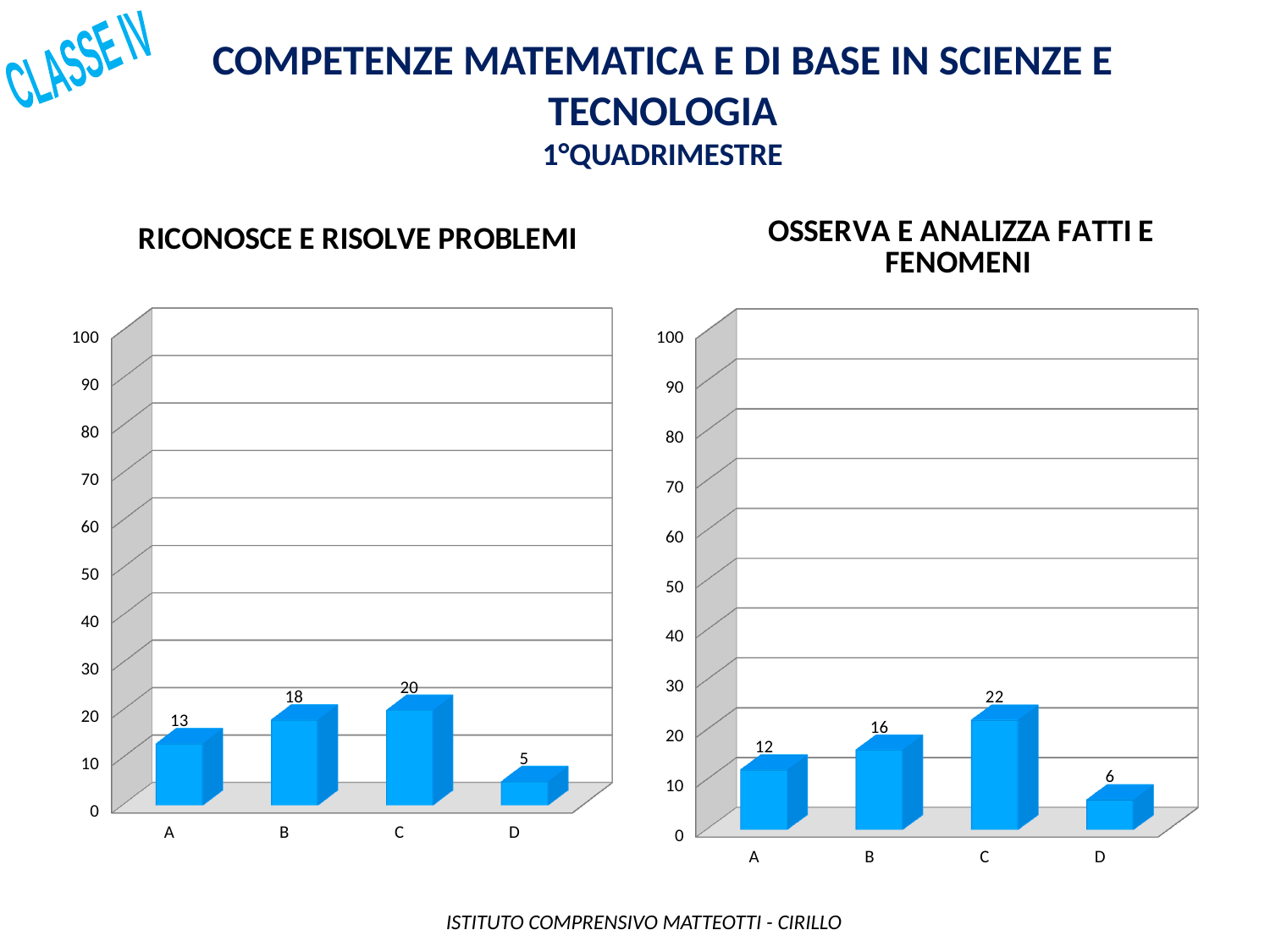
In the 'RICONOSCE E RISOLVE PROBLEMI' chart, is the value for D greater or less than 10? less How many categories are shown in the 'OSSERVA E ANALIZZA FATTI E FENOMENI' chart? 4 What is the title of the chart on the right side of the slide? OSSERVA E ANALIZZA FATTI E FENOMENI What kind of chart is the 'RICONOSCE E RISOLVE PROBLEMI' chart? bar chart In the 'RICONOSCE E RISOLVE PROBLEMI' chart, what is the total of the values for A, B, C and D? 56 In the 'OSSERVA E ANALIZZA FATTI E FENOMENI' chart, what is the value for category C? 22 In the 'OSSERVA E ANALIZZA FATTI E FENOMENI' chart, what is the difference between the values for B and D? 10 In the 'OSSERVA E ANALIZZA FATTI E FENOMENI' chart, which category has the lowest value? D In the 'RICONOSCE E RISOLVE PROBLEMI' chart, what is the difference between the values for C and A? 7 In the 'RICONOSCE E RISOLVE PROBLEMI' chart, what is the value for category B? 18 In the 'OSSERVA E ANALIZZA FATTI E FENOMENI' chart, which is larger, the value for A or the value for B? B In the 'RICONOSCE E RISOLVE PROBLEMI' chart, which category has the highest value? C